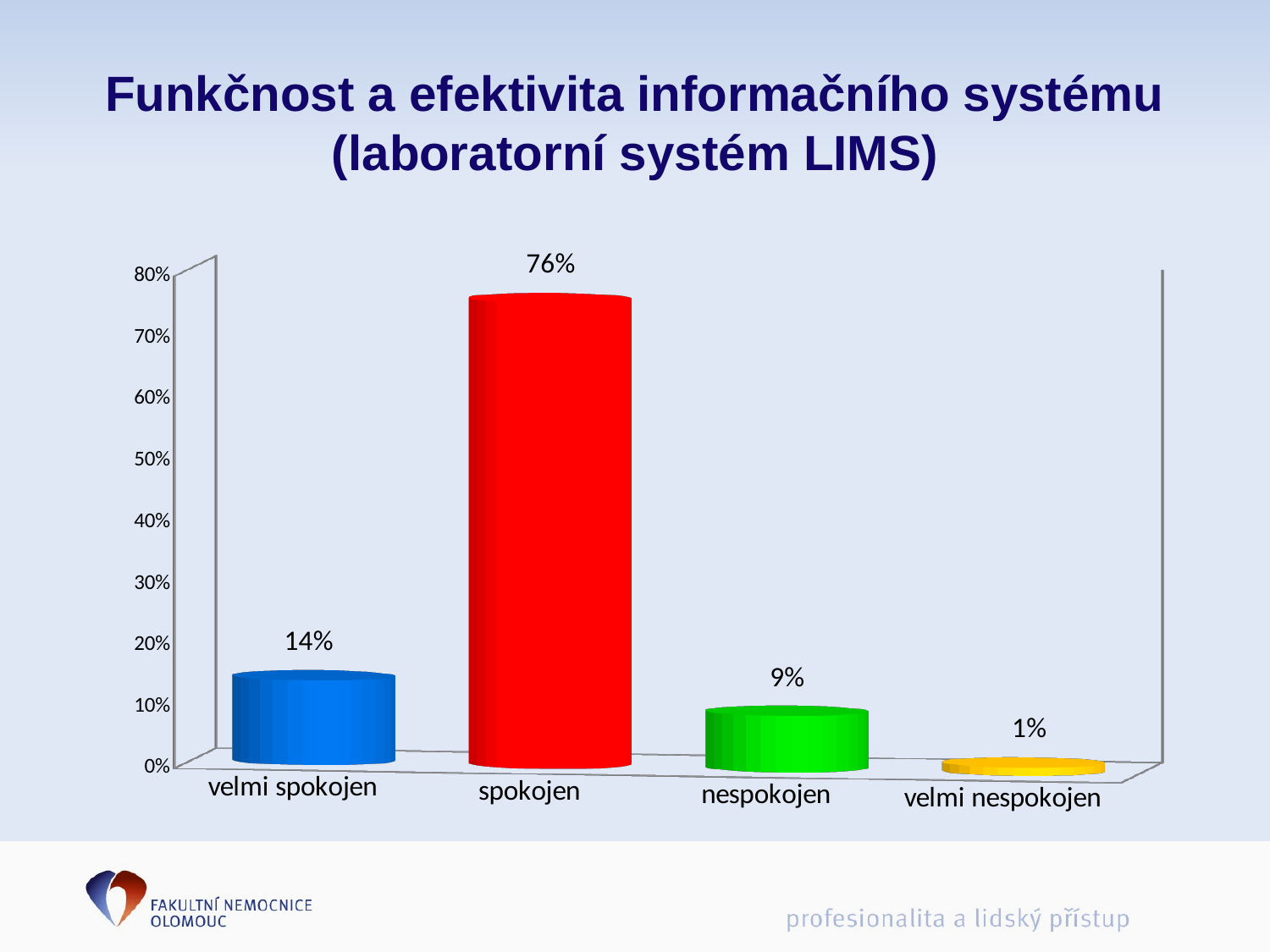
What kind of chart is shown on the slide? bar chart What is the difference between the values for "spokojen" and "velmi spokojen"? 62% What colour is the bar for "spokojen"? red What is the value for "spokojen"? 76% Which is larger, the value for "velmi spokojen" or the value for "nespokojen"? velmi spokojen Which category has the lowest value? velmi nespokojen Which category has the highest value? spokojen What is the value for "nespokojen"? 9% What is the value for "velmi spokojen"? 14% How many categories are shown on the x axis? 4 What is the value for "velmi nespokojen"? 1% What is the difference between the values for "nespokojen" and "velmi nespokojen"? 8%